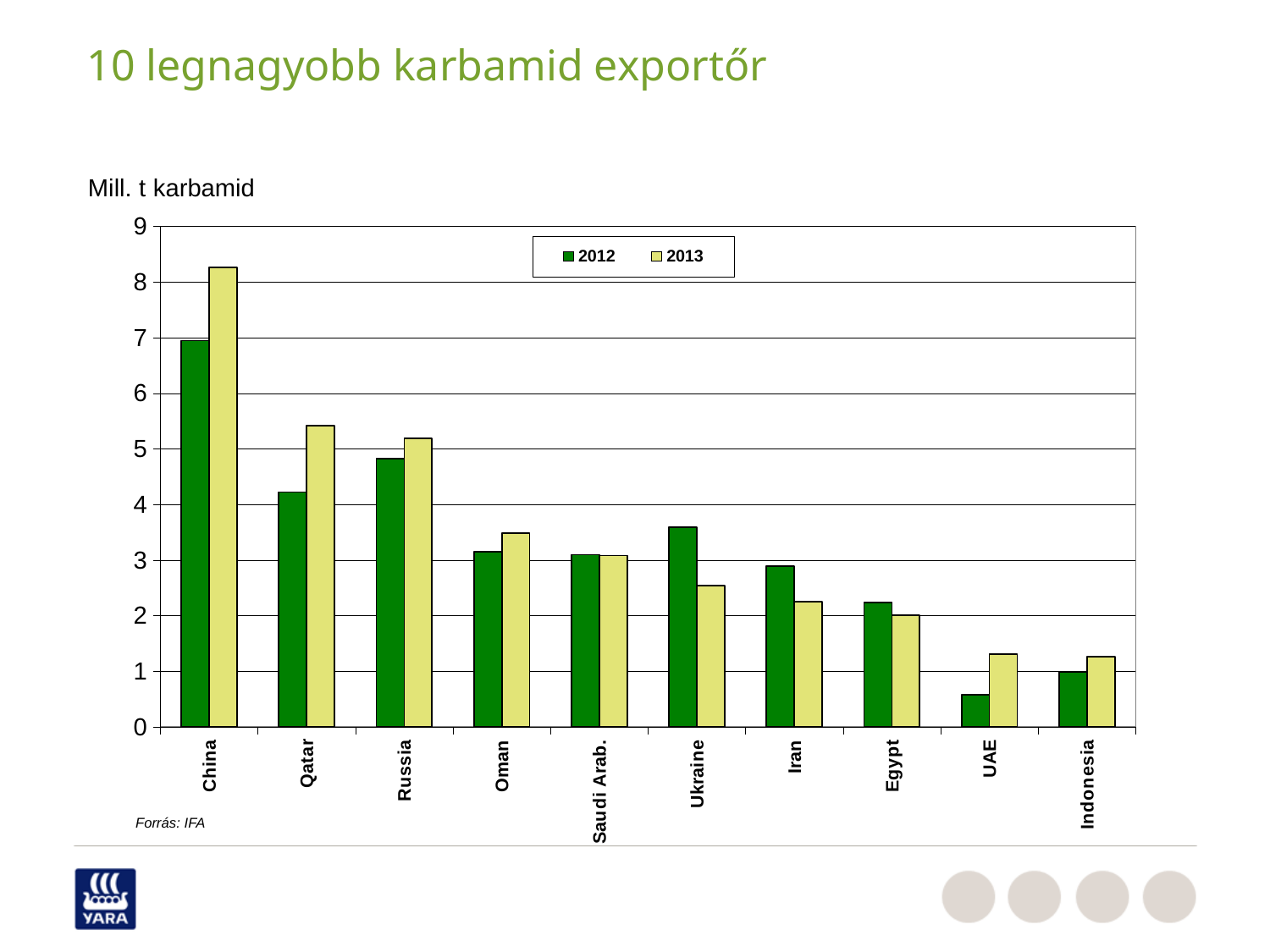
Is the 2012 value for Qatar greater or less than 5? less How many countries are shown on the x axis? 10 Which country has the lowest 2012 value? UAE Which country has the highest 2013 value? China Is the 2013 value for China greater or less than 8? greater How many series does the legend list? 2 What source is cited below the chart? IFA What are the two entries in the legend? 2012 and 2013 What kind of chart is shown on the slide? bar chart Is the 2012 value for UAE greater or less than 1? less For Ukraine, which year has the larger value, 2012 or 2013? 2012 Which has the larger 2012 value, Russia or Qatar? Russia